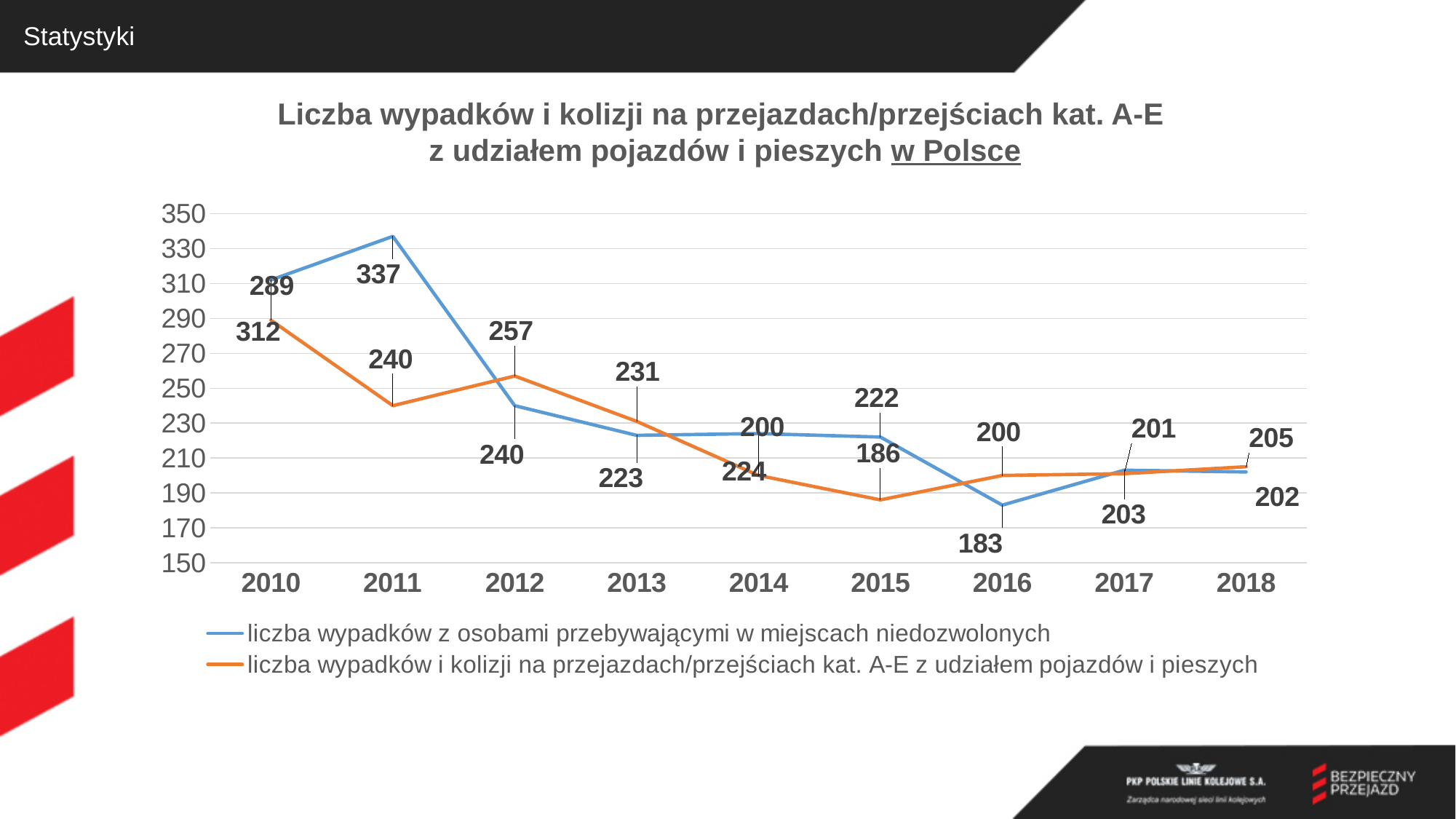
How many series does the legend list? 2 Overall, do the values of the blue series rise or fall from 2011 to 2018? fall In which year does the orange series reach its highest value? 2010 In which year does the blue series reach its highest value? 2011 What is the difference between the blue and orange series in 2011? 97 In 2015, which series has the larger value, blue or orange? blue What is the value of the blue series (liczba wypadków z osobami przebywającymi w miejscach niedozwolonych) in 2016? 183 What kind of chart is shown on the slide? line chart In which year does the blue series reach its lowest value? 2016 What is the value of the orange series (liczba wypadków i kolizji na przejazdach/przejściach kat. A-E) in 2015? 186 What is the value of the blue series (liczba wypadków z osobami przebywającymi w miejscach niedozwolonych) in 2011? 337 How many years are shown on the x axis? 9